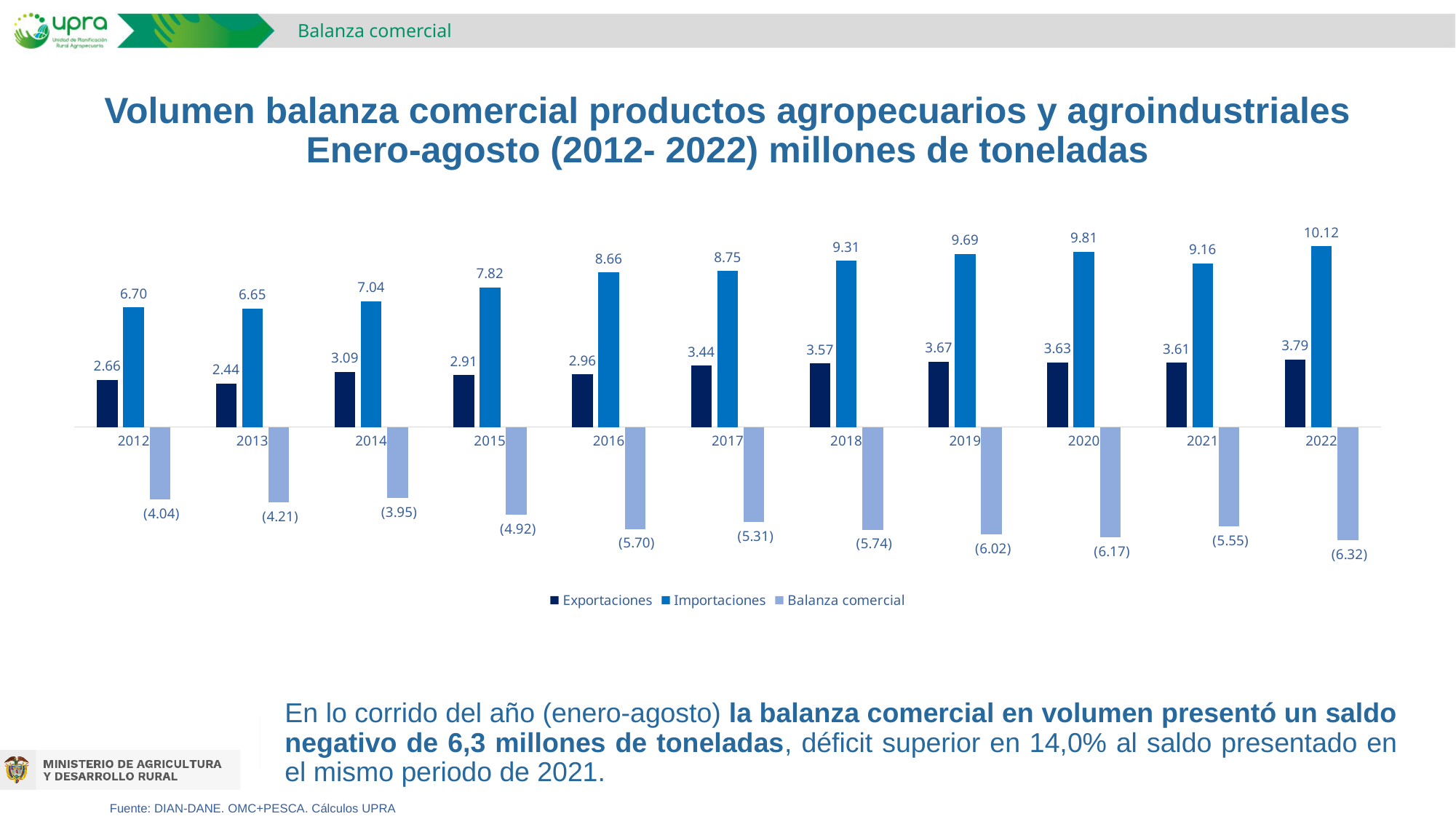
Do the Importaciones values generally rise or fall from 2012 to 2022? Rise What is the value of Exportaciones for 2013? 2.44 How many series does the legend list? 3 What is the value of Importaciones for 2022? 10.12 Which year has the larger Importaciones value, 2020 or 2021? 2020 How many years are shown on the x axis of the chart? 11 What kind of chart is shown on the slide? Bar chart What is the difference between the Exportaciones values for 2022 and 2012? 1.13 What is the value of Balanza comercial for 2016? (5.70) In which year is the Importaciones value highest? 2022 In which year is the Exportaciones value lowest? 2013 What is the difference between the Importaciones values for 2020 and 2019? 0.12